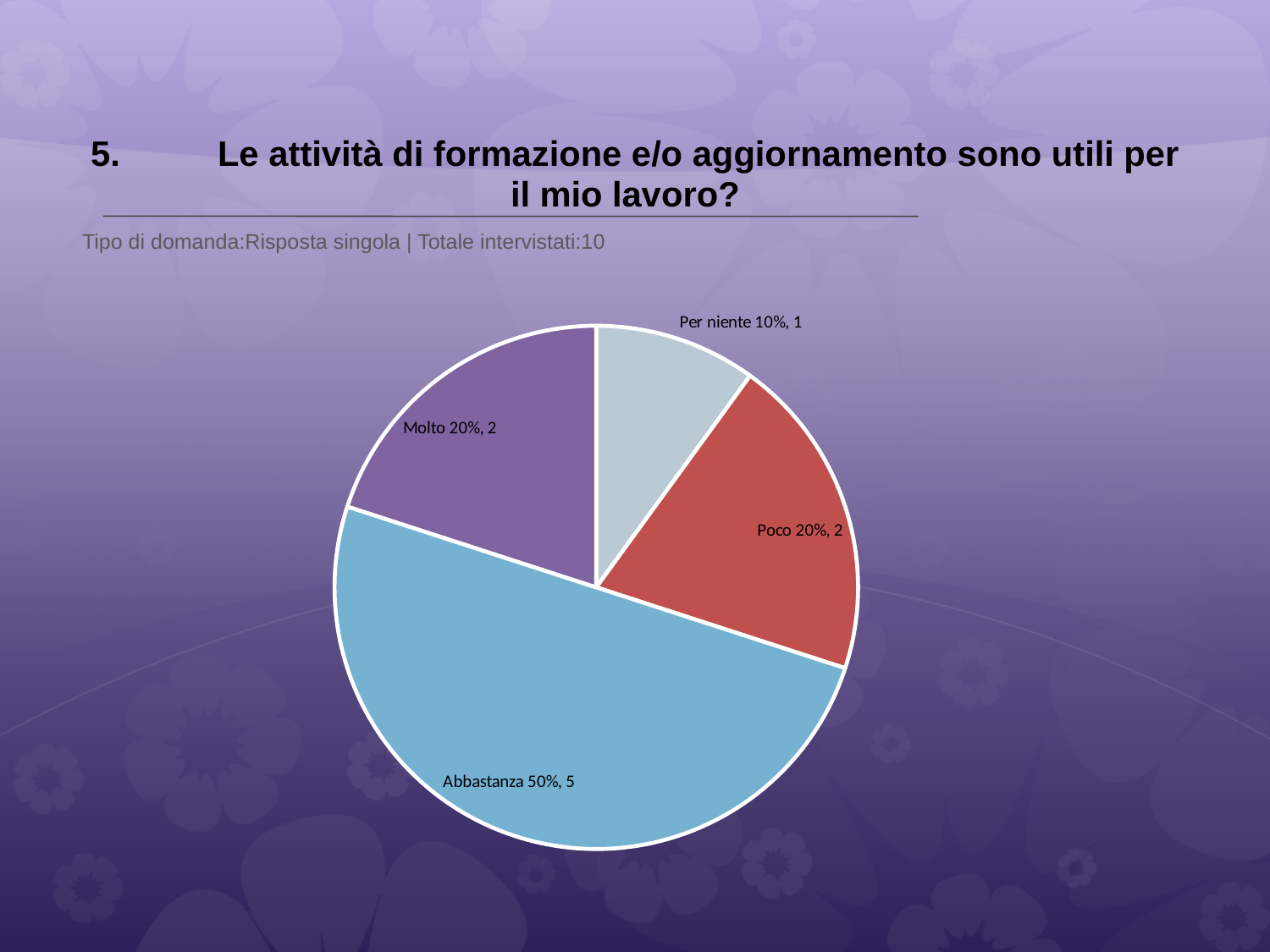
How many respondents answered 'Per niente'? 1 What colour is the 'Abbastanza' slice? blue What is the total number of respondents across all slices? 10 What is the difference in number of respondents between 'Abbastanza' and 'Molto'? 3 What percentage share does the 'Molto' slice have? 20% Which category has the smallest slice of the pie? Per niente Which has more respondents, 'Poco' or 'Per niente'? Poco What percentage share does the 'Abbastanza' slice have? 50% What kind of chart is shown on the slide? pie chart How many slices does the pie chart have? 4 Which category has the largest slice of the pie? Abbastanza How many respondents answered 'Poco'? 2